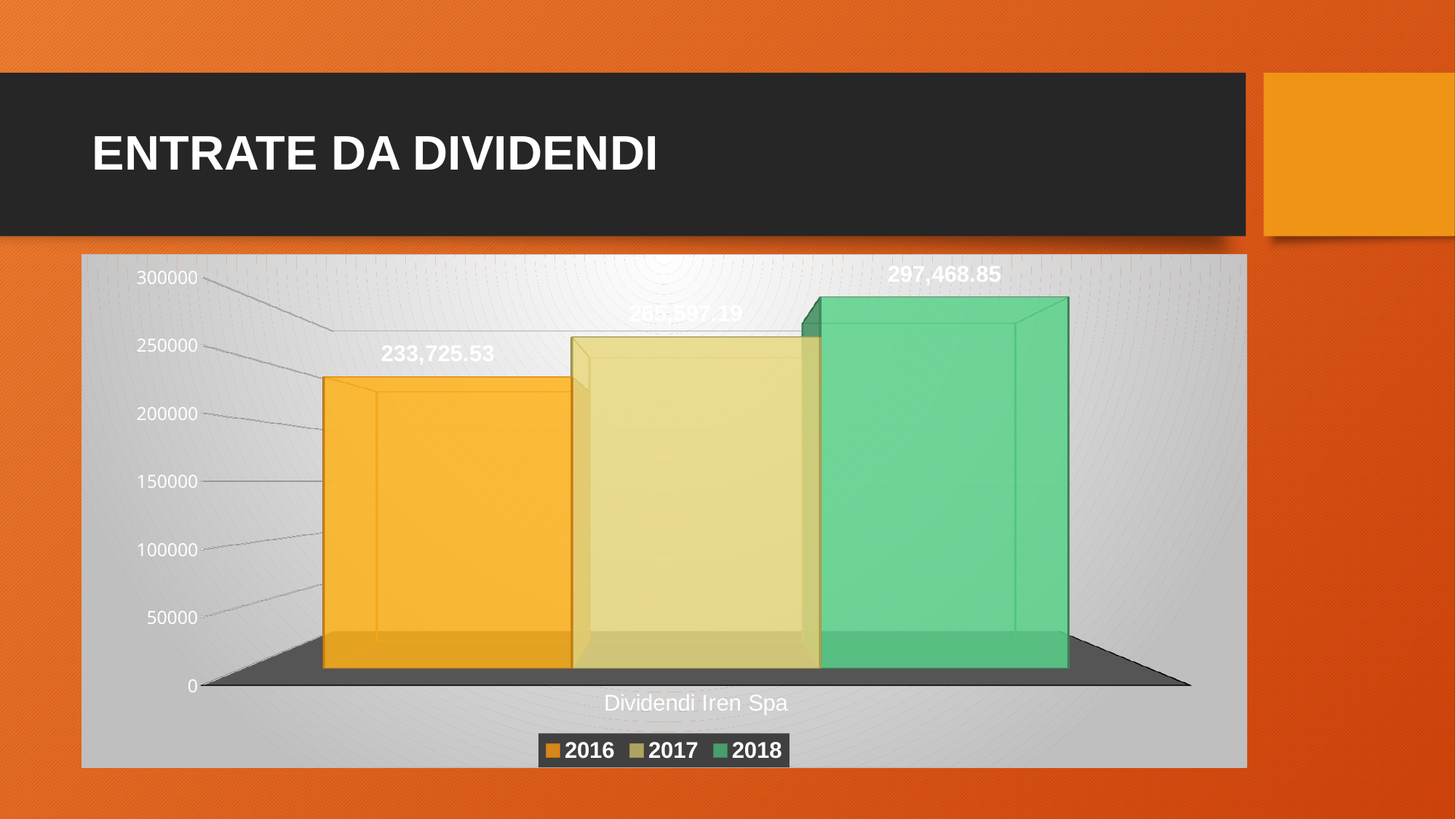
What is the value for 2016 in the Dividendi Iren Spa chart? 233,725.53 Which year has the lowest dividend value? 2016 What is the value for 2017 in the Dividendi Iren Spa chart? 265,597.19 What kind of chart is shown on the slide? Bar chart Which year has the highest dividend value? 2018 How many series does the legend list? 3 What is the value for 2018 in the Dividendi Iren Spa chart? 297,468.85 Is the value for 2016 greater or less than 250000? less Which is larger, the value for 2017 or the value for 2018? 2018 What is the difference between the 2018 and 2016 values? 63,743.32 What is the difference between the 2017 and 2016 values? 31,871.66 What is the category label shown on the x axis? Dividendi Iren Spa